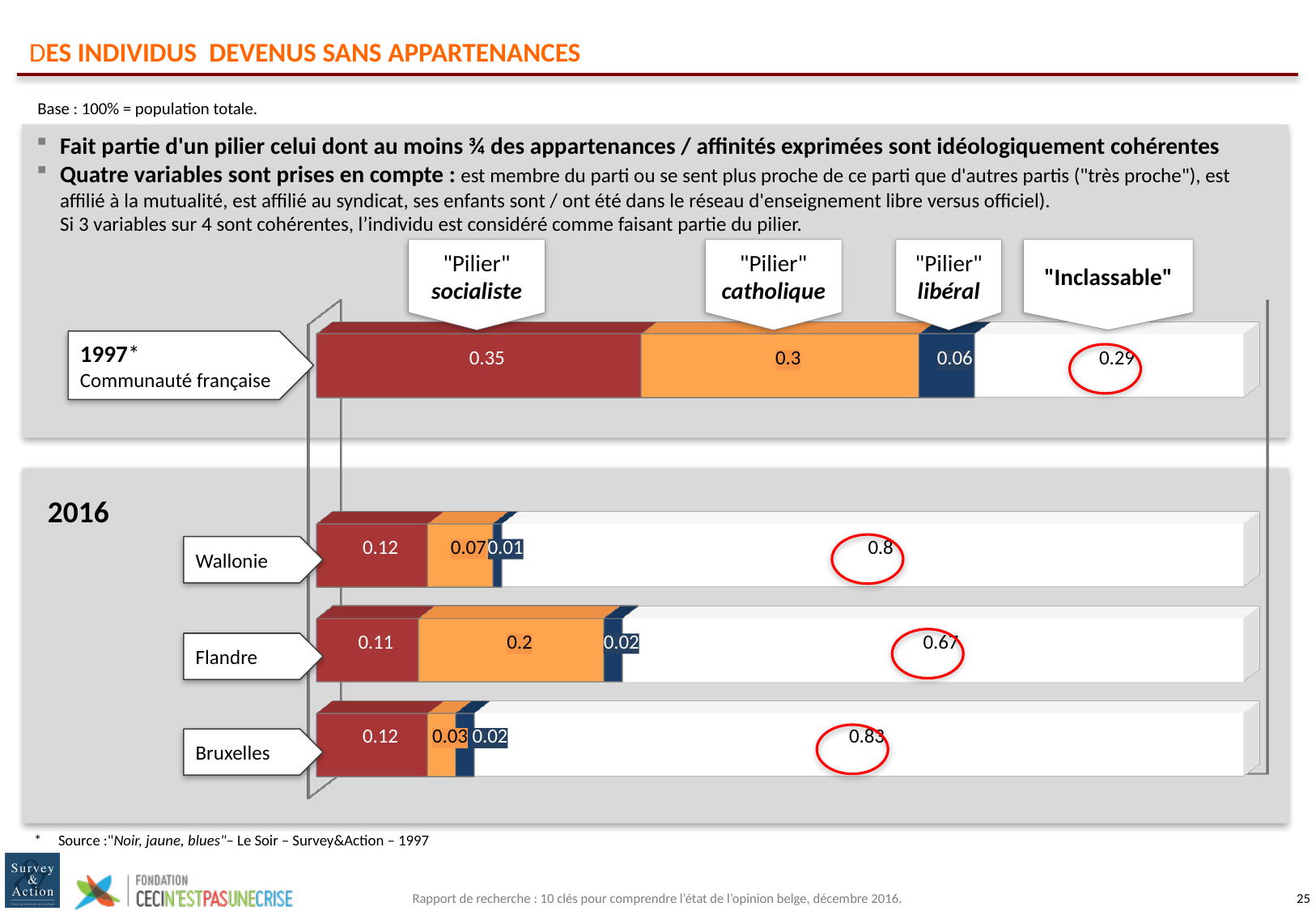
What colour represents the "Pilier" socialiste segment? Dark red Which category has the lowest "Pilier" catholique value? Bruxelles Which category has the highest "Inclassable" value? Bruxelles What is the "Pilier" libéral value for Bruxelles? 0.02 How many bars (categories) are shown in the chart? 4 Which is larger: the "Pilier" catholique value for Wallonie or for Flandre? Flandre How many series are labelled in the chart? 4 What is the value for "Pilier" socialiste for 1997 Communauté française? 0.35 What kind of chart is shown on the slide? Stacked bar chart What is the "Pilier" catholique value for Flandre? 0.2 What is the difference between the "Inclassable" value for Bruxelles and for 1997 Communauté française? 0.54 What is the "Inclassable" value for Wallonie in 2016? 0.8